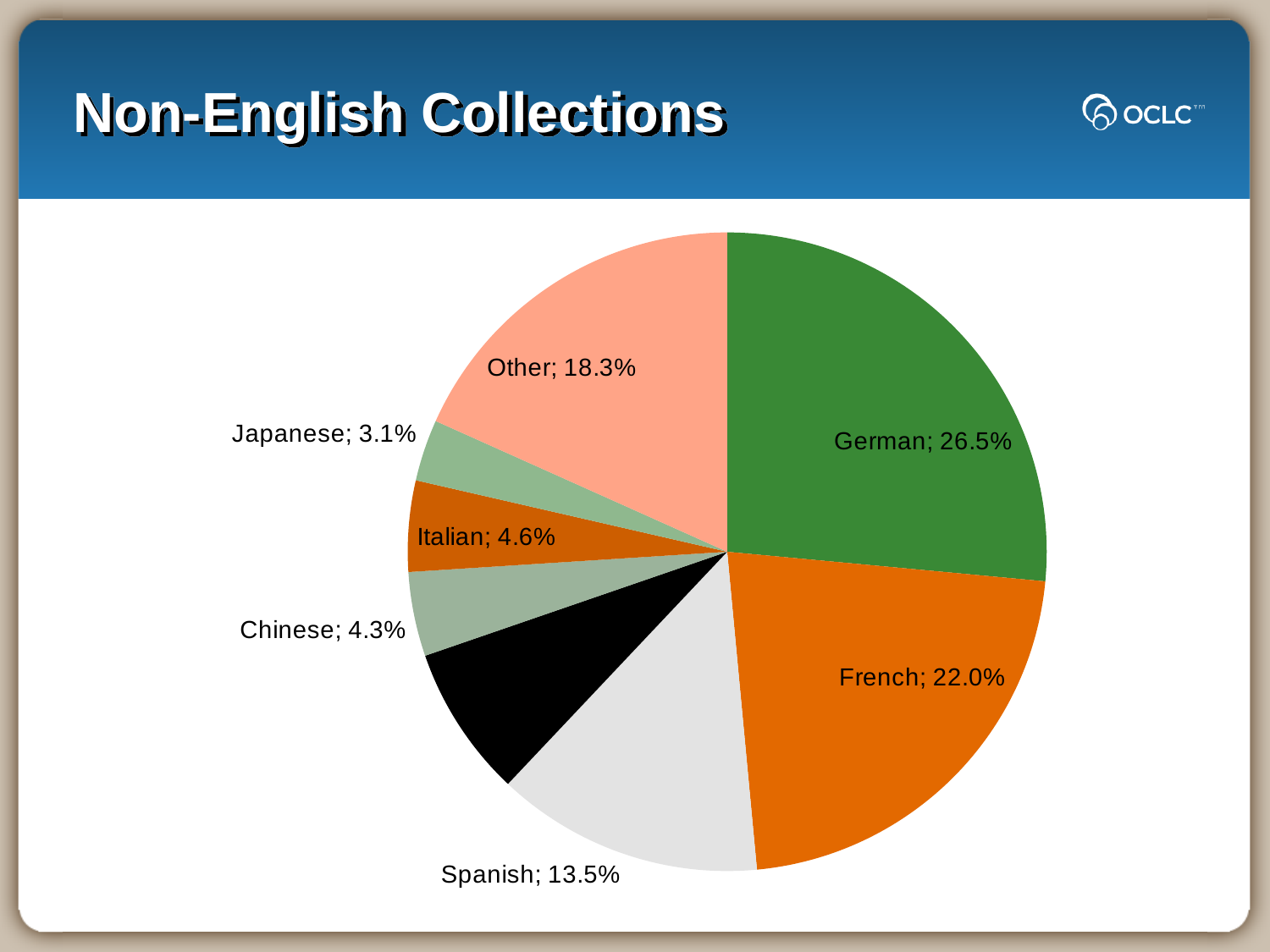
Which slice is larger, Italian or Chinese? Italian Which language has the largest slice of the pie? German Which labeled language has the smallest slice of the pie? Japanese What percentage is shown for French? 22.0% How many slices of the pie have a printed label? 7 What percentage is shown for the Other slice? 18.3% What percentage is shown for Japanese? 3.1% What is the title of the slide containing the chart? Non-English Collections By how many percentage points does German exceed French? 4.5 What share of the pie does German represent? 26.5% What percentage is shown for Spanish? 13.5% What kind of chart is shown on the slide? Pie chart